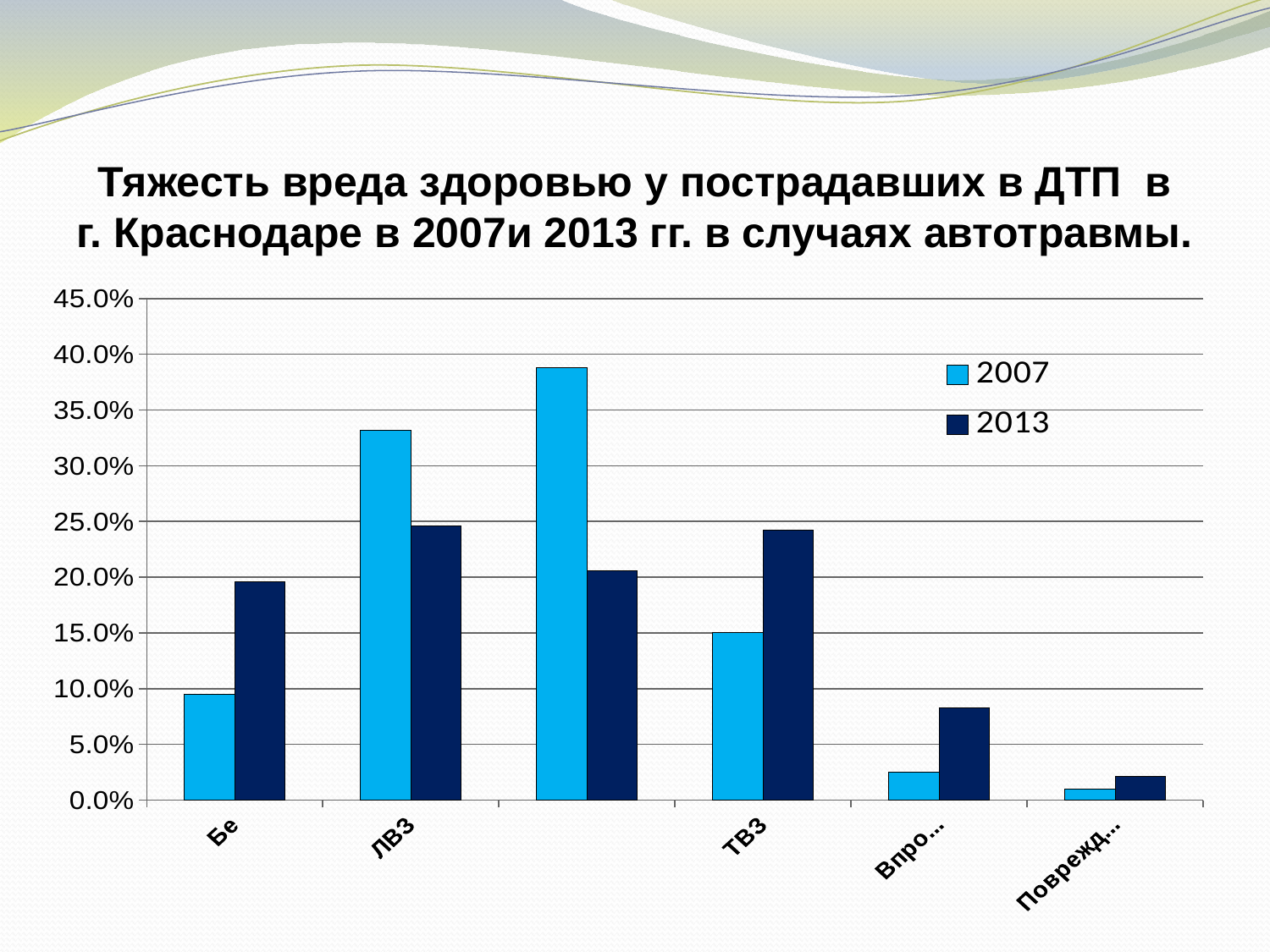
In the 2007 series, which is larger, ЛВЗ or ТВЗ? ЛВЗ How many categories (groups of bars) are plotted along the x axis? 6 Is the 2007 value for ТВЗ greater or less than 10.0%? greater Is the 2013 value for ЛВЗ greater or less than 20.0%? greater Is the 2007 value for ЛВЗ greater or less than 30.0%? greater What are the two series named in the legend? 2007 and 2013 For ЛВЗ, which year has the larger value, 2007 or 2013? 2007 How many series does the legend list? 2 What kind of chart is shown on the slide? bar chart For ТВЗ, which year has the larger value, 2007 or 2013? 2013